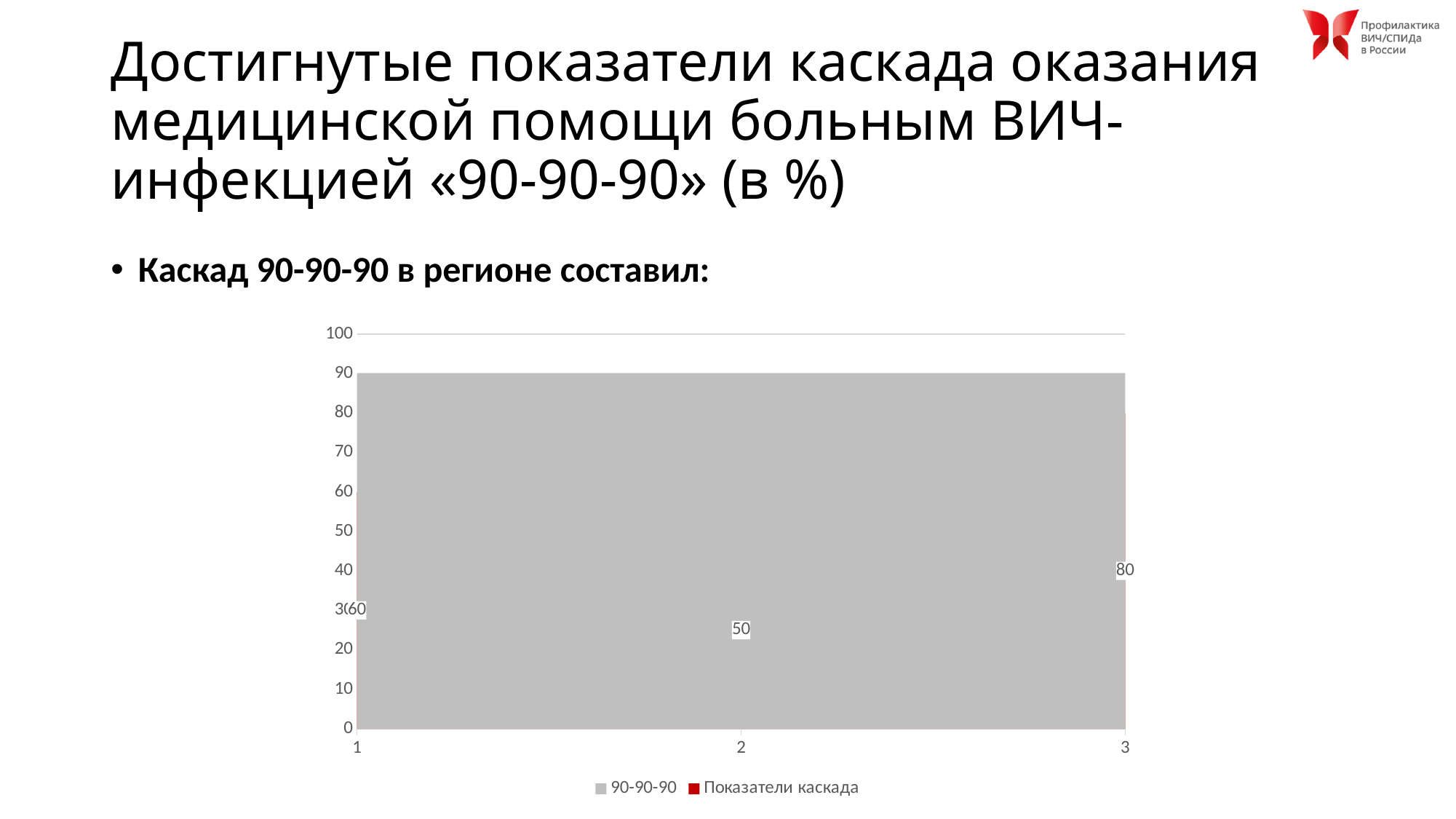
Which is larger for the 'Показатели каскада' series: the value at category 1 or at category 2? category 1 What is the difference between the 'Показатели каскада' values at category 3 and category 2? 30 What value is labelled for the 'Показатели каскада' series at category 2? 50 What kind of chart is shown on the slide? area chart What value is labelled for the 'Показатели каскада' series at category 3? 80 What are the two series names listed in the legend? 90-90-90 and Показатели каскада How many series does the legend list? 2 At which category does the 'Показатели каскада' series have its lowest labelled value? 2 What value is labelled for the 'Показатели каскада' series at category 1? 60 Is the value of the grey '90-90-90' area greater or less than 80? greater At which category does the 'Показатели каскада' series reach its highest labelled value? 3 How many categories are shown on the x axis? 3